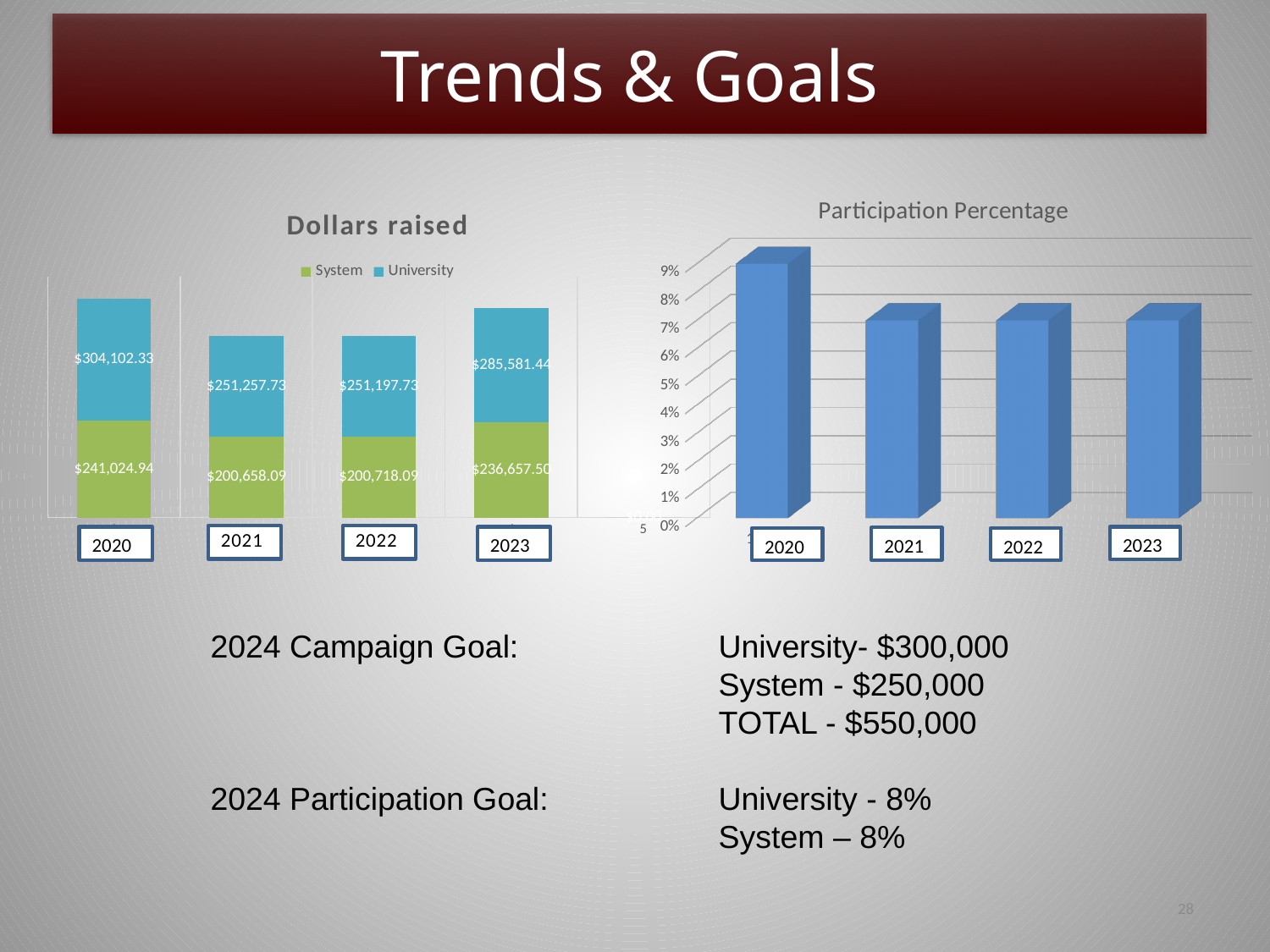
In the Participation Percentage chart, which year has the highest participation? 2020 In the Dollars raised chart, what is the System value for 2021? $200,658.09 In the Dollars raised chart, which is larger: the System value for 2020 or the System value for 2021? 2020 In the Participation Percentage chart, is the value for 2020 greater or less than 8%? greater In the Dollars raised chart, which year has the highest University value? 2020 How many series does the legend of the Dollars raised chart list? 2 In the Participation Percentage chart, is the value for 2021 greater or less than 8%? less What kind of chart is the Participation Percentage chart? bar chart In the Dollars raised chart, what is the difference between the University values for 2020 and 2023? $18,520.89 In the Dollars raised chart, what is the total of the stacked bar for 2020? $545,127.27 In the Dollars raised chart, what is the University value for 2020? $304,102.33 In the Dollars raised chart, what is the System value for 2023? $236,657.50